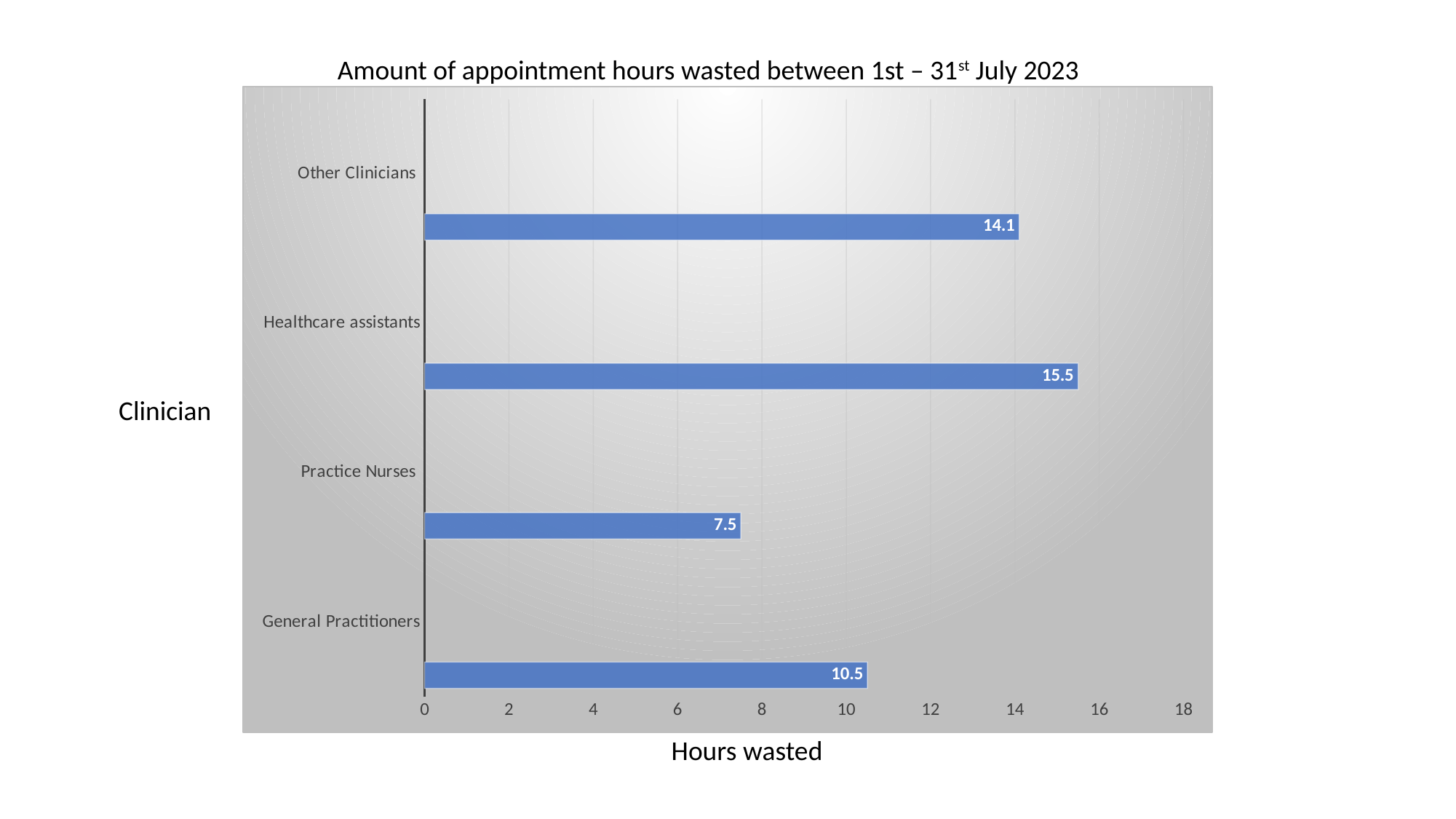
What is the title of the chart? Amount of appointment hours wasted between 1st – 31st July 2023 How many hours were wasted for Other Clinicians? 14.1 What is the difference in hours wasted between Healthcare assistants and Practice Nurses? 8 Which clinician group has the highest number of hours wasted? Healthcare assistants How many hours were wasted for General Practitioners? 10.5 What kind of chart is shown on the slide? bar chart What is the difference in hours wasted between Other Clinicians and General Practitioners? 3.6 How many hours were wasted for Healthcare assistants? 15.5 How many clinician groups are shown in the chart? 4 Which has more hours wasted, General Practitioners or Other Clinicians? Other Clinicians How many hours were wasted for Practice Nurses? 7.5 Which clinician group has the lowest number of hours wasted? Practice Nurses